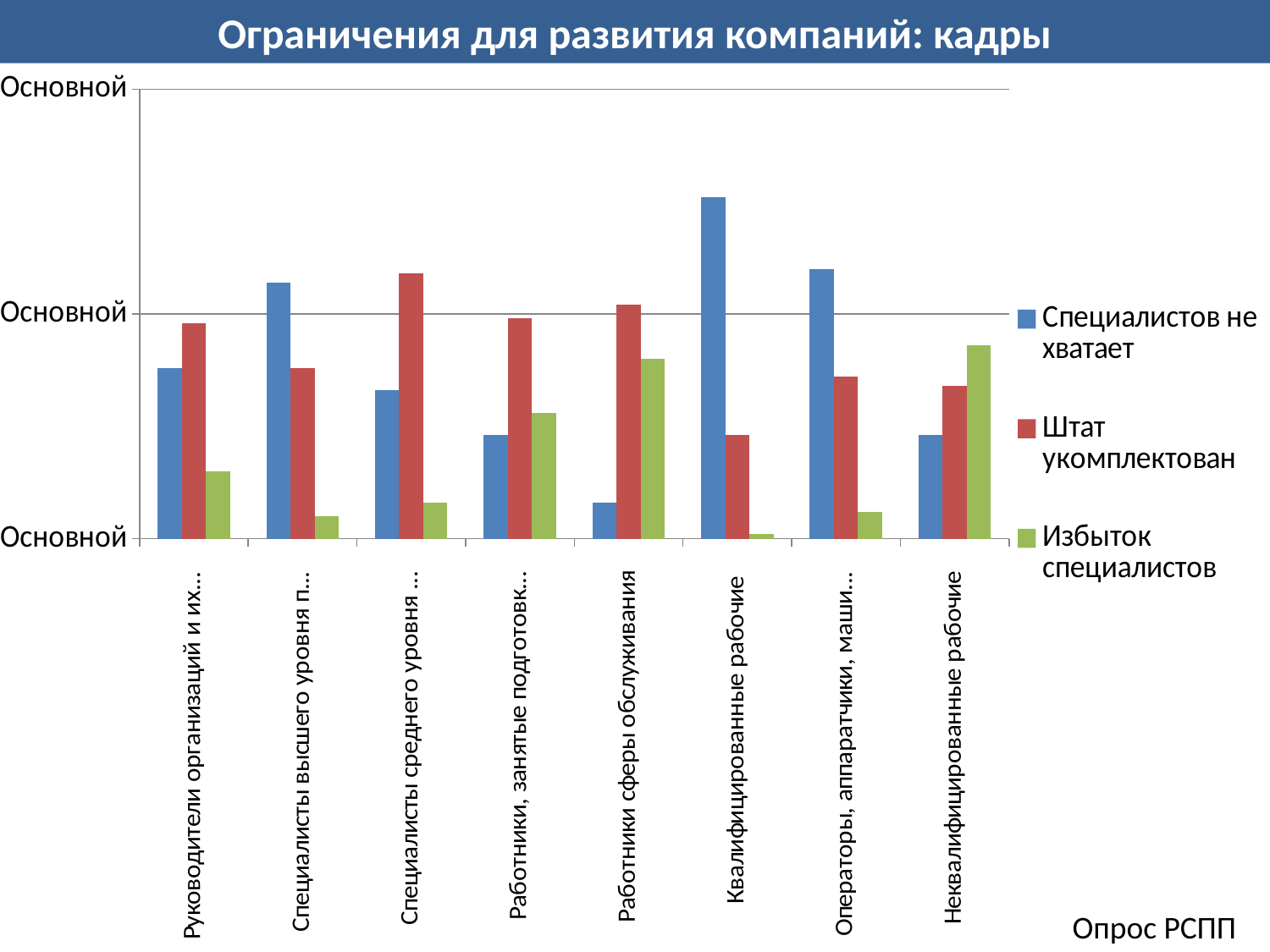
What kind of chart is shown on the slide? Bar chart Which category has the lowest value for the series "Избыток специалистов"? Квалифицированные рабочие How many categories are shown along the x axis? 8 Which category has the highest value for the series "Специалистов не хватает"? Квалифицированные рабочие Which series is shown in red in the legend? Штат укомплектован What is the title of the slide? Ограничения для развития компаний: кадры How many series does the legend list? 3 For "Работники сферы обслуживания", which series has the larger value: "Специалистов не хватает" or "Штат укомплектован"? Штат укомплектован Which category has the highest value for the series "Избыток специалистов"? Неквалифицированные рабочие For "Квалифицированные рабочие", which series has the larger value: "Специалистов не хватает" or "Штат укомплектован"? Специалистов не хватает For "Неквалифицированные рабочие", which series has the larger value: "Специалистов не хватает" or "Избыток специалистов"? Избыток специалистов Which category has the lowest value for the series "Специалистов не хватает"? Работники сферы обслуживания